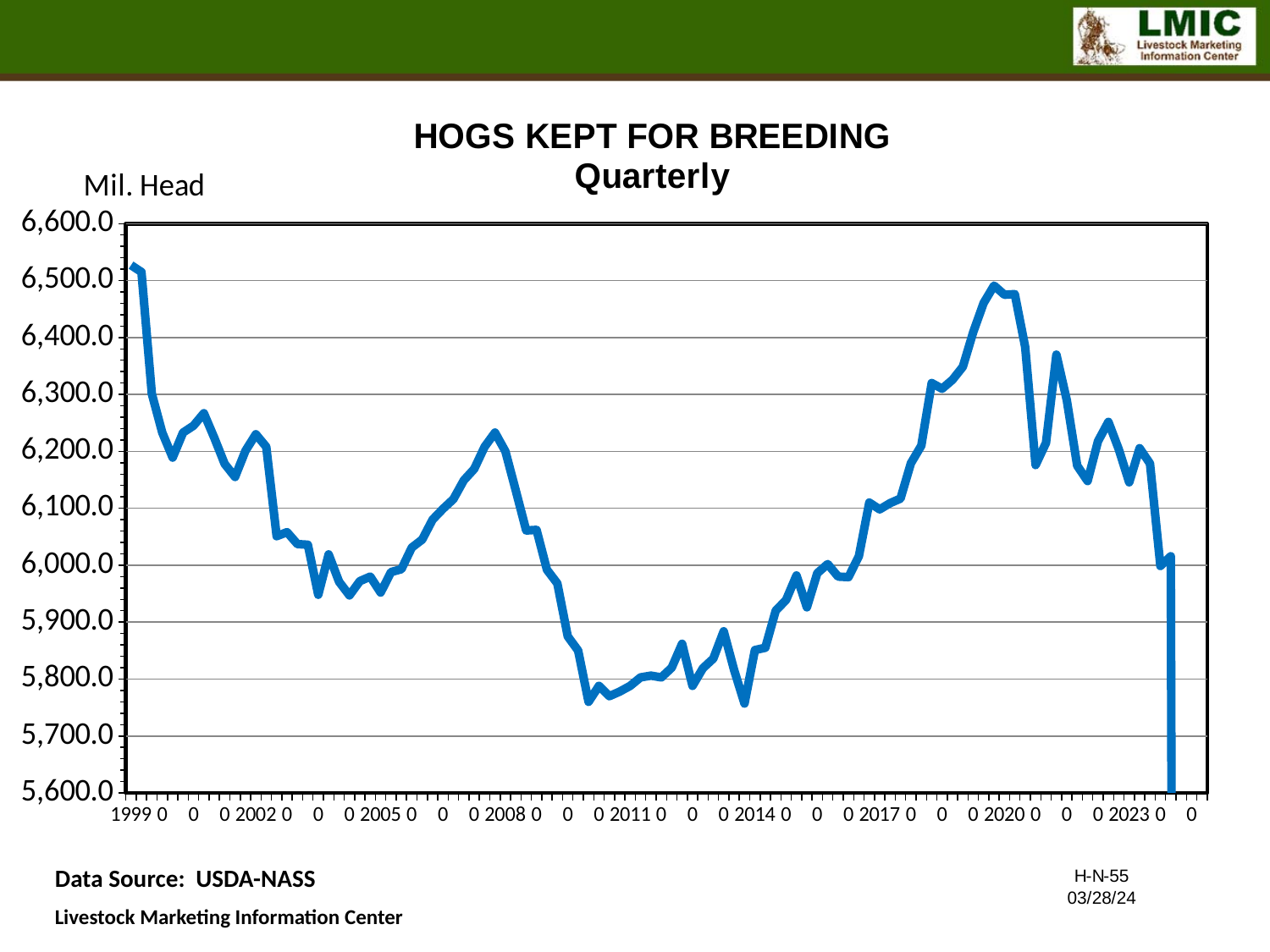
Is the value around 2011 greater or less than 5,900? less Is the peak value around 2020 greater or less than 6,400? greater Around which year does the line reach its highest point after 2010? 2020 Does the line rise or fall from 1999 to 2002? fall Which is larger, the value in 1999 or the value in 2011? 1999 How many lines are plotted on the chart? 1 Is the peak value around 2008 greater or less than 6,100? greater Does the line rise or fall from 2014 to 2020? rise What is the title of the chart? HOGS KEPT FOR BREEDING Quarterly What kind of chart is shown on the slide? line chart What unit is shown on the y axis of the chart? Mil. Head